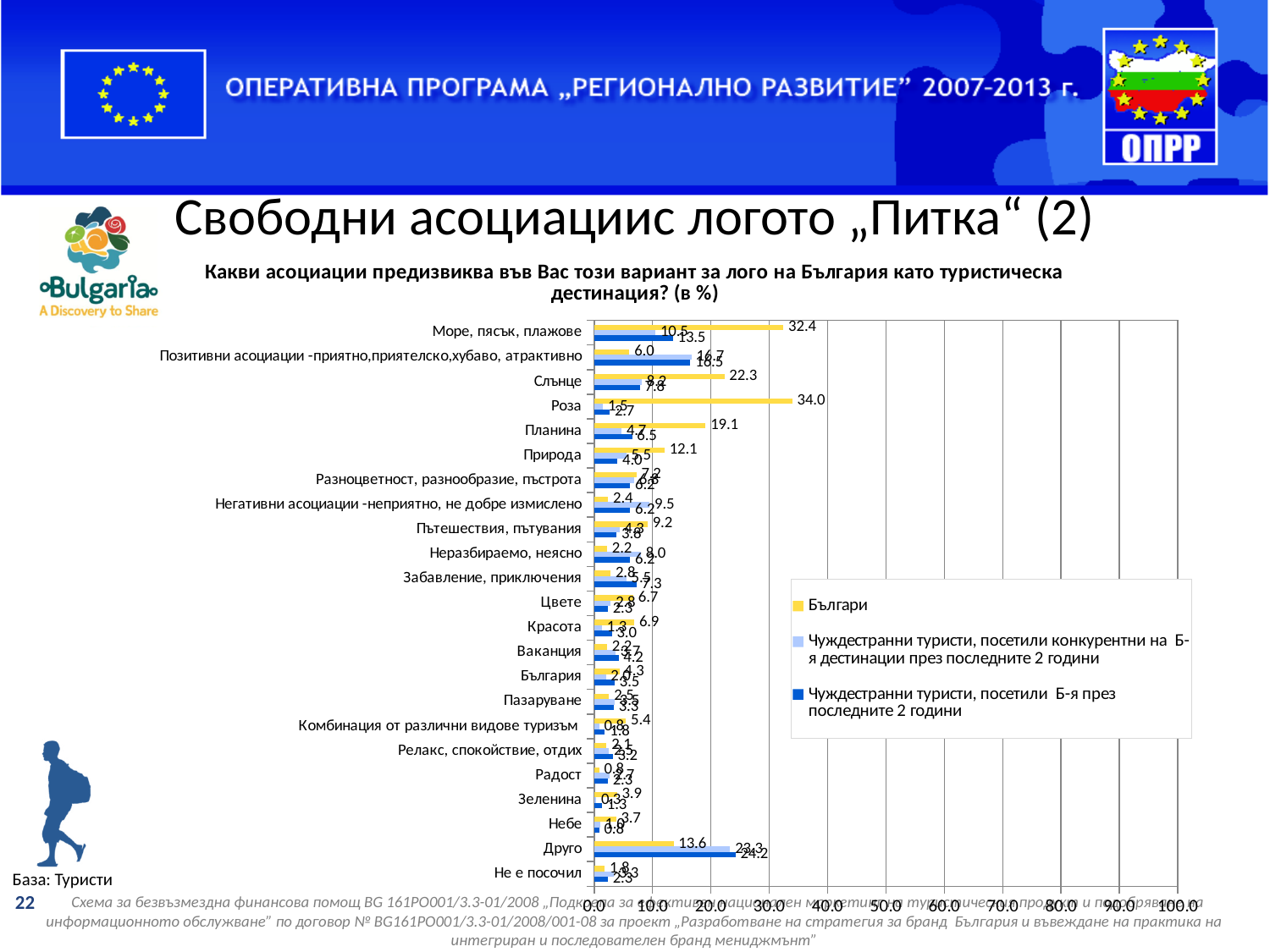
Which category has the highest value for the Българи series? Роза What colour represents the Българи series in the chart? yellow What is the value for Българи for the category Планина? 19.1 What is the difference between the Българи values for Роза and Море, пясък, плажове? 1.6 What kind of chart is shown on the slide? bar chart What is the value for Българи for the category Слънце? 22.3 What is the value for Българи for the category Роза? 34.0 How many categories are shown on the chart? 23 Is the value for Българи for the category Природа greater or less than 10.0? greater What is the value for Българи for the category Море, пясък, плажове? 32.4 How many series does the legend list? 3 For the category Друго, which series has the larger value: Българи or Чуждестранни туристи, посетили Б-я през последните 2 години? Чуждестранни туристи, посетили Б-я през последните 2 години